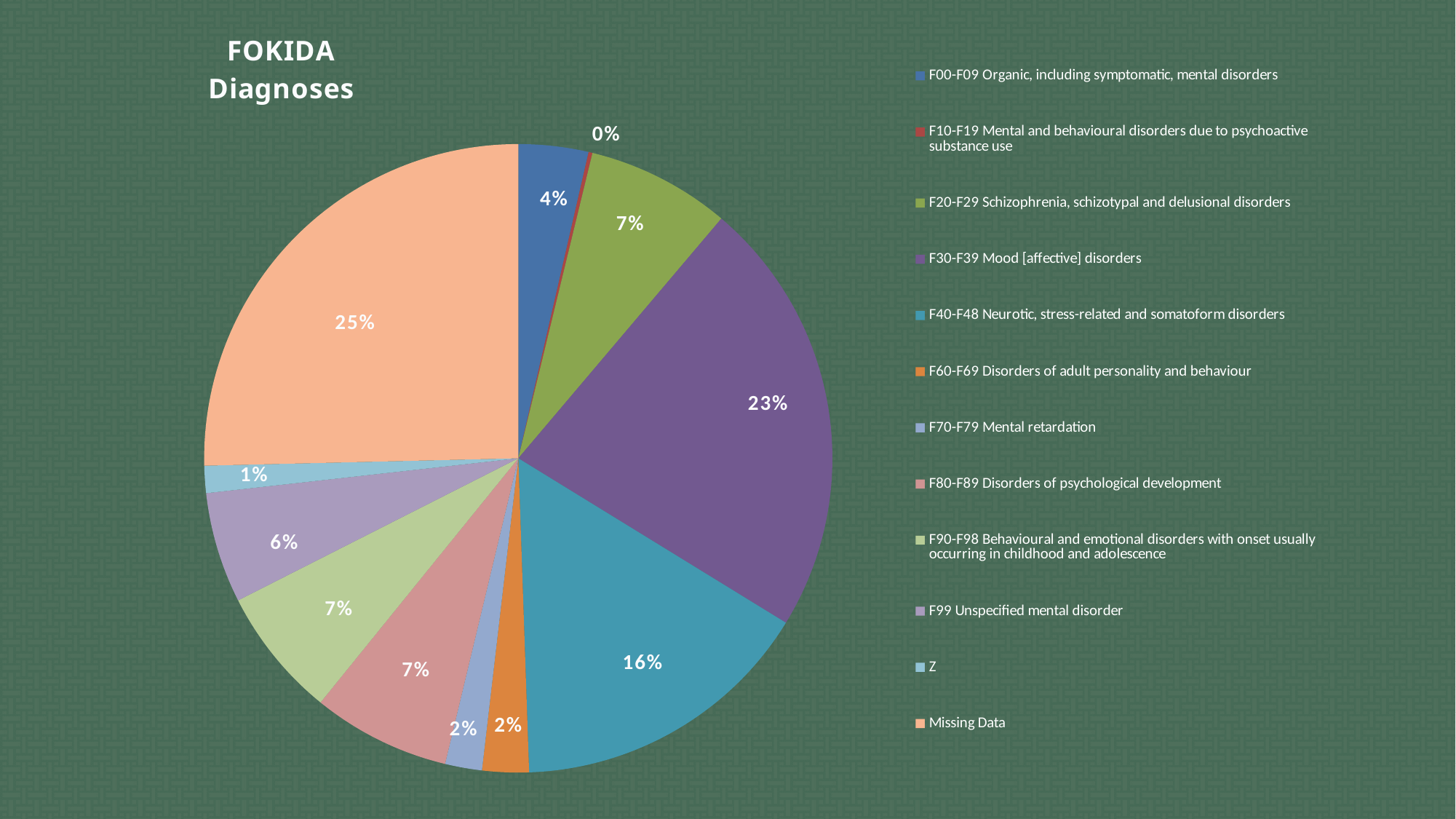
Which is larger, the slice for F99 Unspecified mental disorder or the slice for Z? F99 Unspecified mental disorder What percentage is shown for F10-F19 Mental and behavioural disorders due to psychoactive substance use? 0% What share of the pie is F40-F48 Neurotic, stress-related and somatoform disorders? 16% What share of the pie is F30-F39 Mood [affective] disorders? 23% What is the difference in percentage points between F30-F39 Mood [affective] disorders and F40-F48 Neurotic, stress-related and somatoform disorders? 7 How many categories does the legend of the FOKIDA Diagnoses chart list? 12 What is the title of the pie chart? FOKIDA Diagnoses What share of the pie is Missing Data? 25% Which category has the smallest slice of the pie? F10-F19 Mental and behavioural disorders due to psychoactive substance use Which category has the largest slice of the pie? Missing Data What type of chart is shown on the slide? Pie chart What percentage is shown for F00-F09 Organic, including symptomatic, mental disorders? 4%